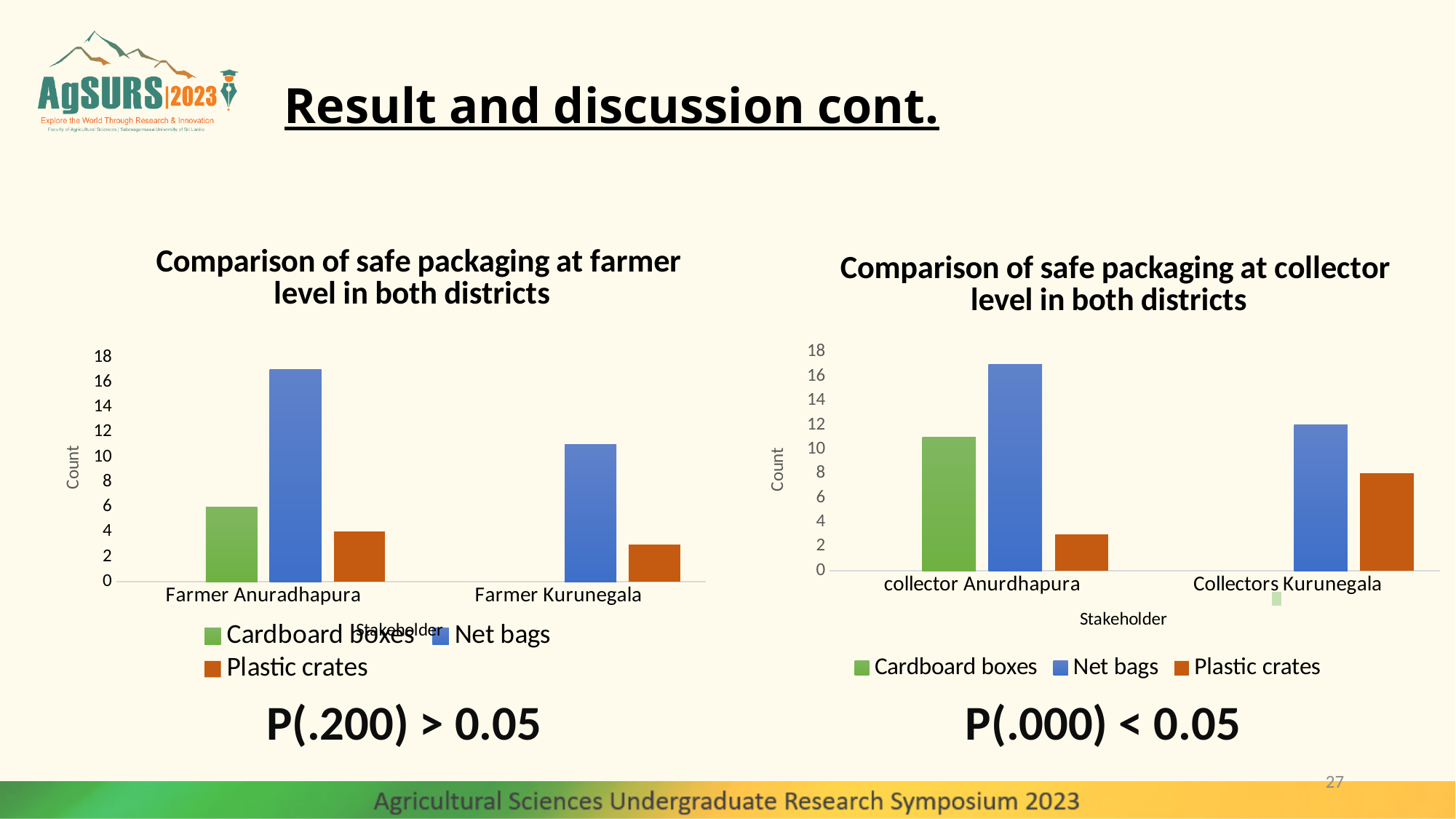
In the collector level chart, which is larger for Collectors Kurunegala: Net bags or Plastic crates? Net bags In the farmer level chart, which is larger for Farmer Anuradhapura: Cardboard boxes or Plastic crates? Cardboard boxes In the farmer level chart, which series has the highest bar for Farmer Anuradhapura? Net bags In the collector level chart, is the value for Cardboard boxes at collector Anurdhapura greater or less than 8? greater What is the y-axis label of the collector level chart? Count In the farmer level chart, is the value for Net bags at Farmer Kurunegala greater or less than 8? greater In the collector level chart, what is the value for Net bags at Collectors Kurunegala? 12 In the collector level chart, which series has the lowest bar for collector Anurdhapura? Plastic crates In the farmer level chart, what is the value for Cardboard boxes at Farmer Anuradhapura? 6 In the farmer level chart, is the value for Net bags at Farmer Anuradhapura greater or less than 14? greater How many series does the legend list in the 'Comparison of safe packaging at collector level in both districts' chart? 3 What type of chart is the 'Comparison of safe packaging at farmer level in both districts' chart? bar chart